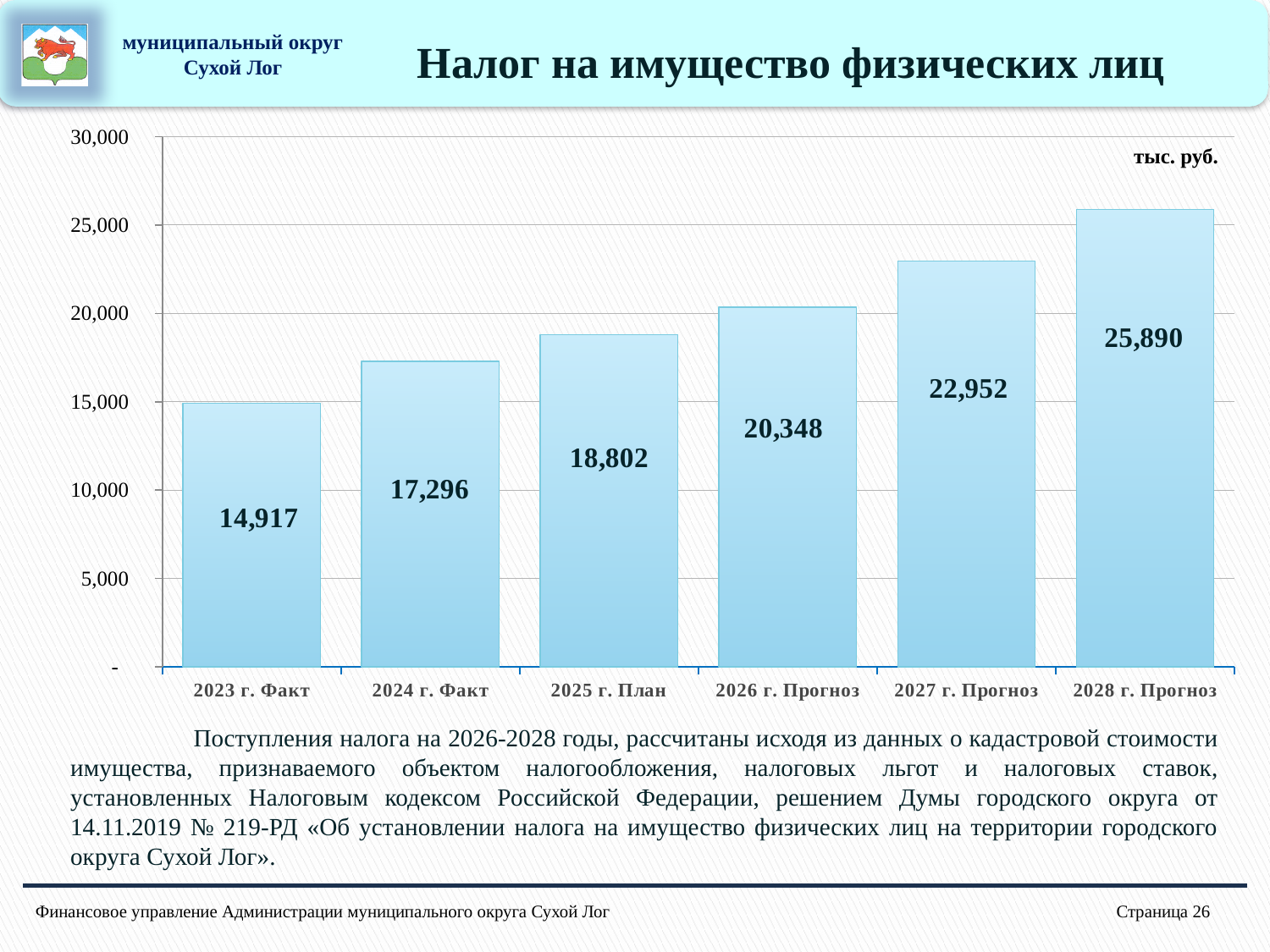
Which category has the highest value? 2028 г. Прогноз What is the value for 2023 г. Факт? 14,917 Which category has the lowest value? 2023 г. Факт Is the value for 2026 г. Прогноз greater or less than 20,000? greater What is the value for 2025 г. План? 18,802 What is the difference between the values for 2024 г. Факт and 2023 г. Факт? 2,379 What is the difference between the values for 2028 г. Прогноз and 2027 г. Прогноз? 2,938 Which is larger, the value for 2026 г. Прогноз or the value for 2025 г. План? 2026 г. Прогноз What is the value for 2027 г. Прогноз? 22,952 What kind of chart is shown on the slide? bar chart How many categories are shown on the x axis? 6 Do the values rise or fall from 2023 г. Факт to 2028 г. Прогноз? rise